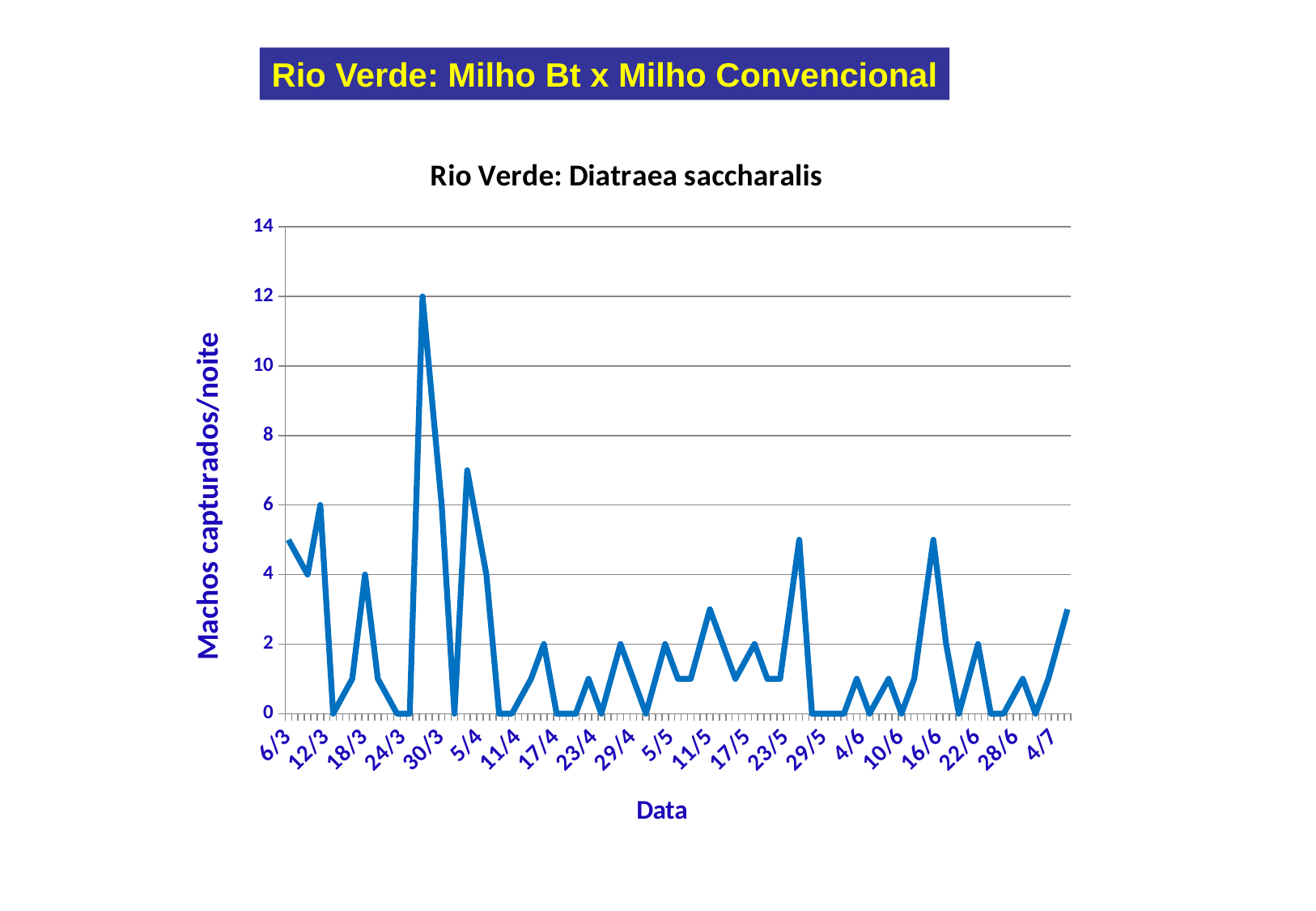
What is the title of the chart? Rio Verde: Diatraea saccharalis What is the lowest value reached by the line? 0 What is the maximum value shown on the y axis? 14 Is the value for 4/7 greater or less than 4? less Is the peak value of the line greater or less than 10? greater What is the highest value reached by the line? 12 Is the value for 6/3 greater or less than 6? less What is the label of the y axis? Machos capturados/noite What kind of chart is shown on the slide? line chart Which is larger, the value for 6/3 or the value for 4/7? 6/3